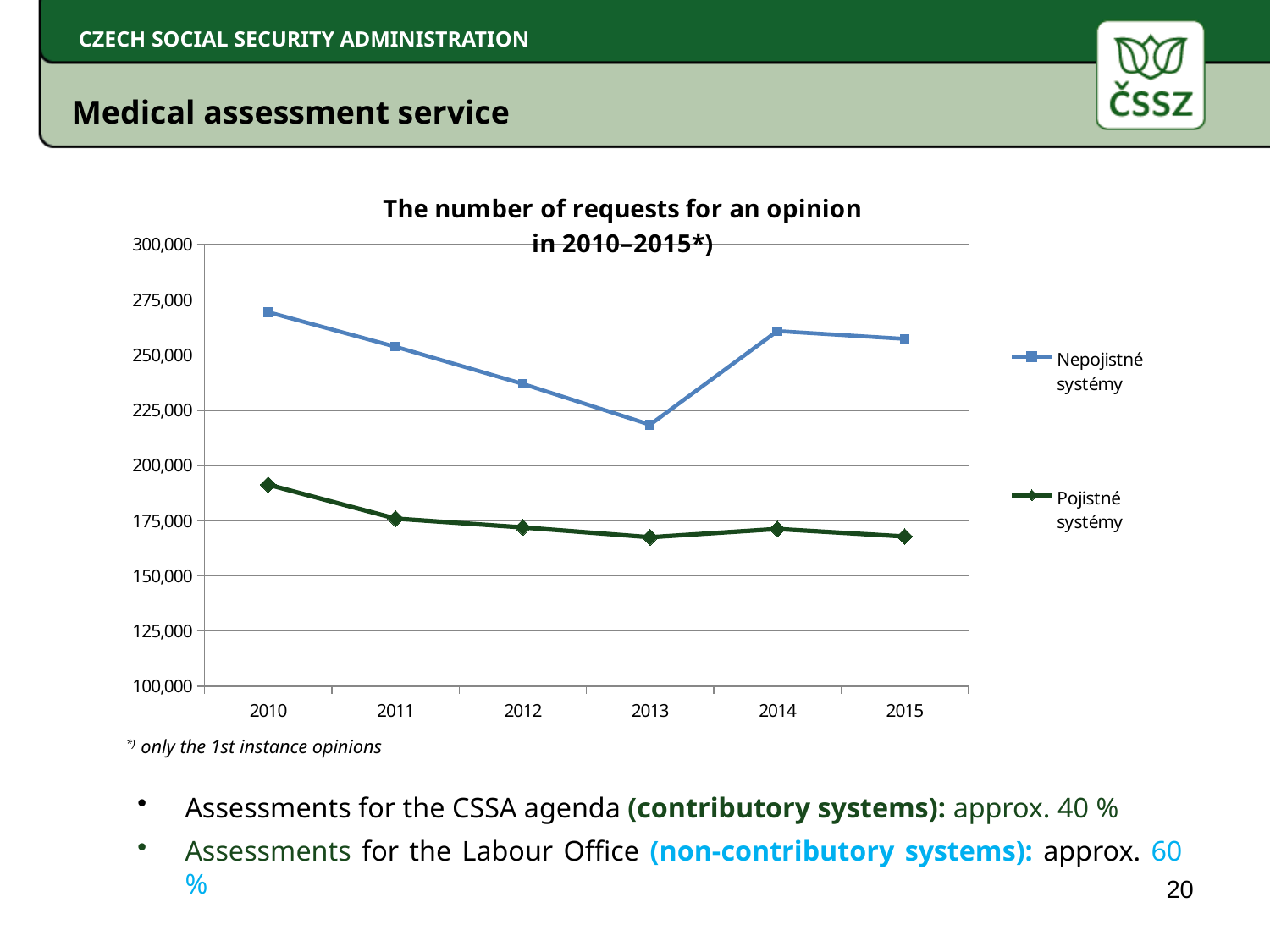
Is the value for Nepojistné systémy in 2010 greater or less than 250,000? greater Does the value for Pojistné systémy rise or fall from 2010 to 2013? fall What is the title of the chart? The number of requests for an opinion in 2010–2015*) How many years are plotted along the x axis? 6 In 2014, which series has the larger value, Nepojistné systémy or Pojistné systémy? Nepojistné systémy In which year is the value for Nepojistné systémy lowest? 2013 Is the value for Nepojistné systémy in 2013 greater or less than 225,000? less How many series does the legend list? 2 In which year is the value for Pojistné systémy highest? 2010 What kind of chart is shown on the slide? line chart Is the value for Pojistné systémy in 2010 greater or less than 175,000? greater In which year is the value for Nepojistné systémy highest? 2010